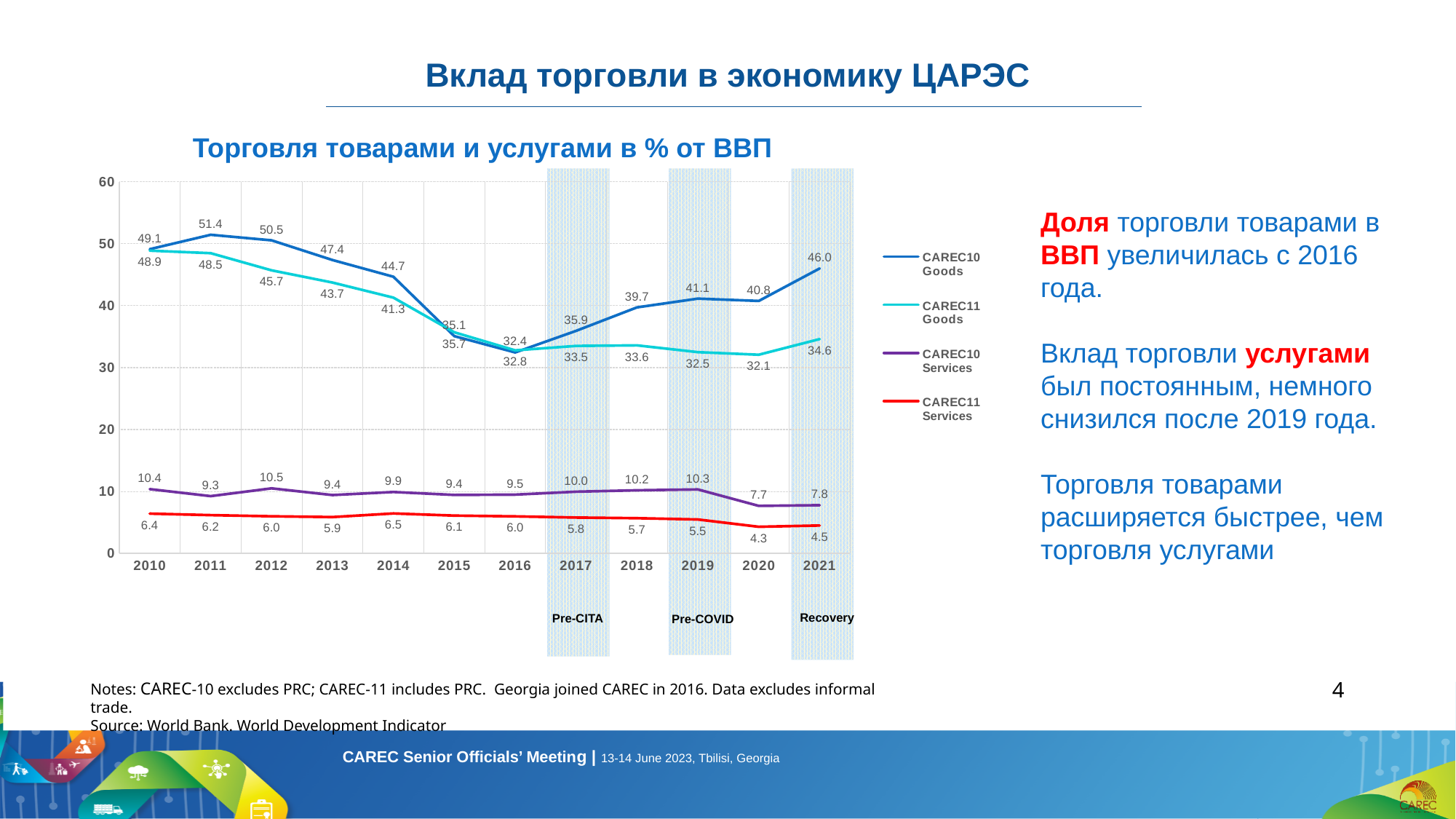
In which year is CAREC11 Services at its lowest? 2020 How many series does the chart legend list? 4 Does CAREC11 Goods rise or fall from 2010 to 2014? fall What kind of chart is shown on the slide? line chart What is the value of CAREC11 Services in 2020? 4.3 What is the difference between CAREC10 Services in 2019 and in 2020? 2.6 How many years are plotted along the x axis of the chart? 12 By how much did CAREC10 Goods increase from 2016 to 2021? 13.6 In 2019, which is larger: CAREC10 Goods or CAREC11 Goods? CAREC10 Goods In which year is CAREC10 Goods at its highest? 2011 What is the value of CAREC10 Goods in 2021? 46.0 What is the value of CAREC10 Services in 2012? 10.5